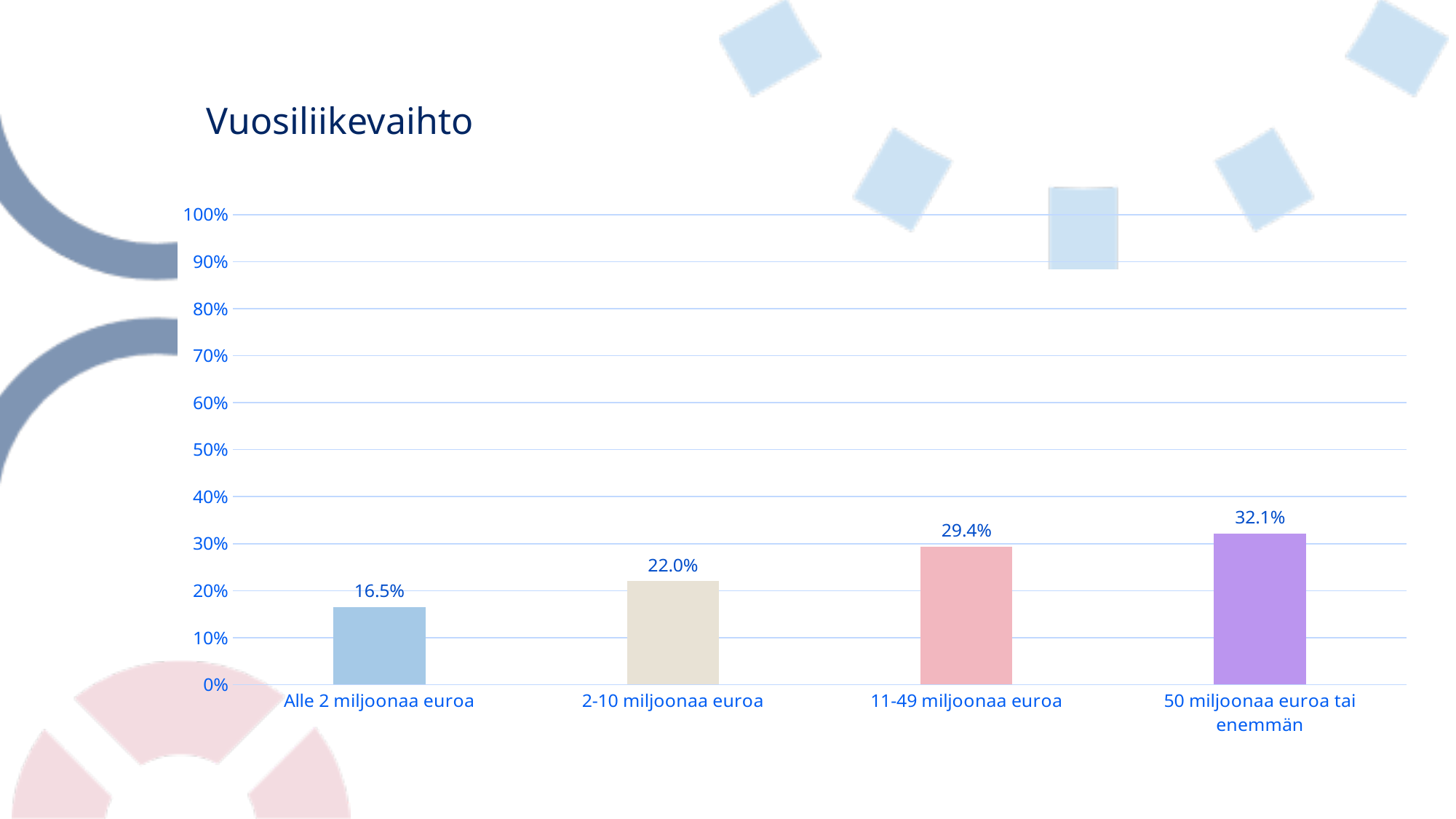
What is the value for "Alle 2 miljoonaa euroa"? 16.5% Which category has the highest value? 50 miljoonaa euroa tai enemmän What kind of chart is shown on the slide? bar chart Is the value for "11-49 miljoonaa euroa" greater or less than 30%? less Do the values rise or fall from left to right along the x axis? rise What is the difference between the values for "50 miljoonaa euroa tai enemmän" and "Alle 2 miljoonaa euroa"? 15.6% How many categories are shown on the x axis? 4 What is the value for "11-49 miljoonaa euroa"? 29.4% What is the value for "2-10 miljoonaa euroa"? 22.0% Which category has the lowest value? Alle 2 miljoonaa euroa What is the value for "50 miljoonaa euroa tai enemmän"? 32.1% Which is larger, the value for "2-10 miljoonaa euroa" or "11-49 miljoonaa euroa"? 11-49 miljoonaa euroa